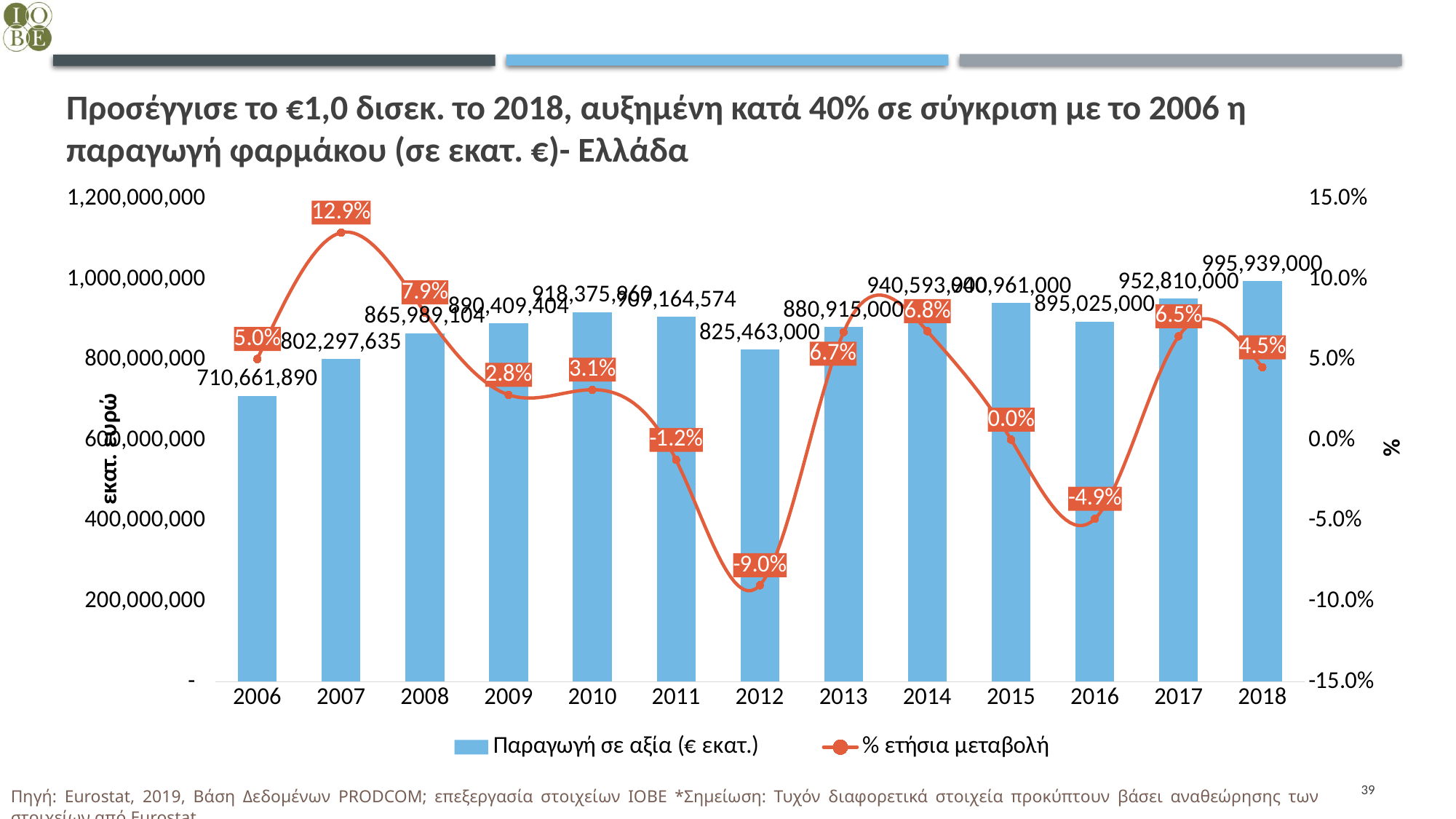
What is the production value (Παραγωγή σε αξία) for 2006? 710,661,890 How many years are shown on the x axis? 13 How many series does the legend list? 2 What is the % annual change (% ετήσια μεταβολή) for 2007? 12.9% What is the % annual change (% ετήσια μεταβολή) for 2012? -9.0% Is the production value for 2012 greater or less than 800,000,000? greater What is the production value (Παραγωγή σε αξία) for 2018? 995,939,000 What is the difference in production value between 2018 and 2006? 285,277,110 Which year has the highest production value? 2018 Which year has the lowest % annual change? 2012 Which is larger, the production value for 2017 or for 2016? 2017 Which year has the highest % annual change? 2007